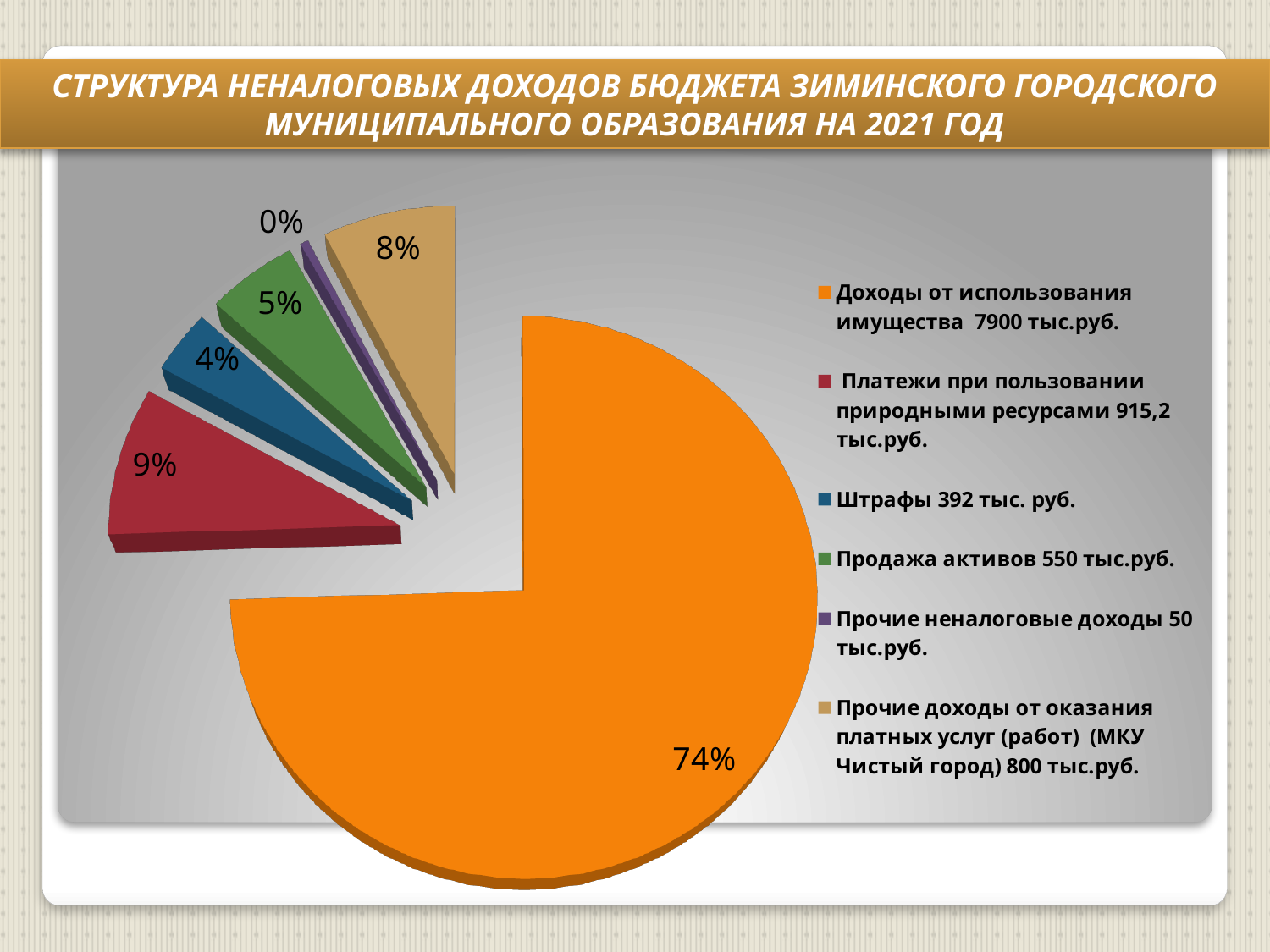
What share of the pie does "Прочие доходы от оказания платных услуг (работ) (МКУ Чистый город)" take? 8% What share of the pie does "Штрафы" take? 4% Which category has the smallest slice of the pie? Прочие неналоговые доходы Which category has the largest slice of the pie? Доходы от использования имущества What share of the pie does "Доходы от использования имущества" take? 74% Which slice is larger: "Продажа активов" or "Штрафы"? Продажа активов How many slices does the pie chart have? 6 What kind of chart is shown on the slide? Pie chart What amount is listed in the legend for "Штрафы"? 392 тыс. руб. What is the difference in percentage points between the "Платежи при пользовании природными ресурсами" slice and the "Продажа активов" slice? 4%